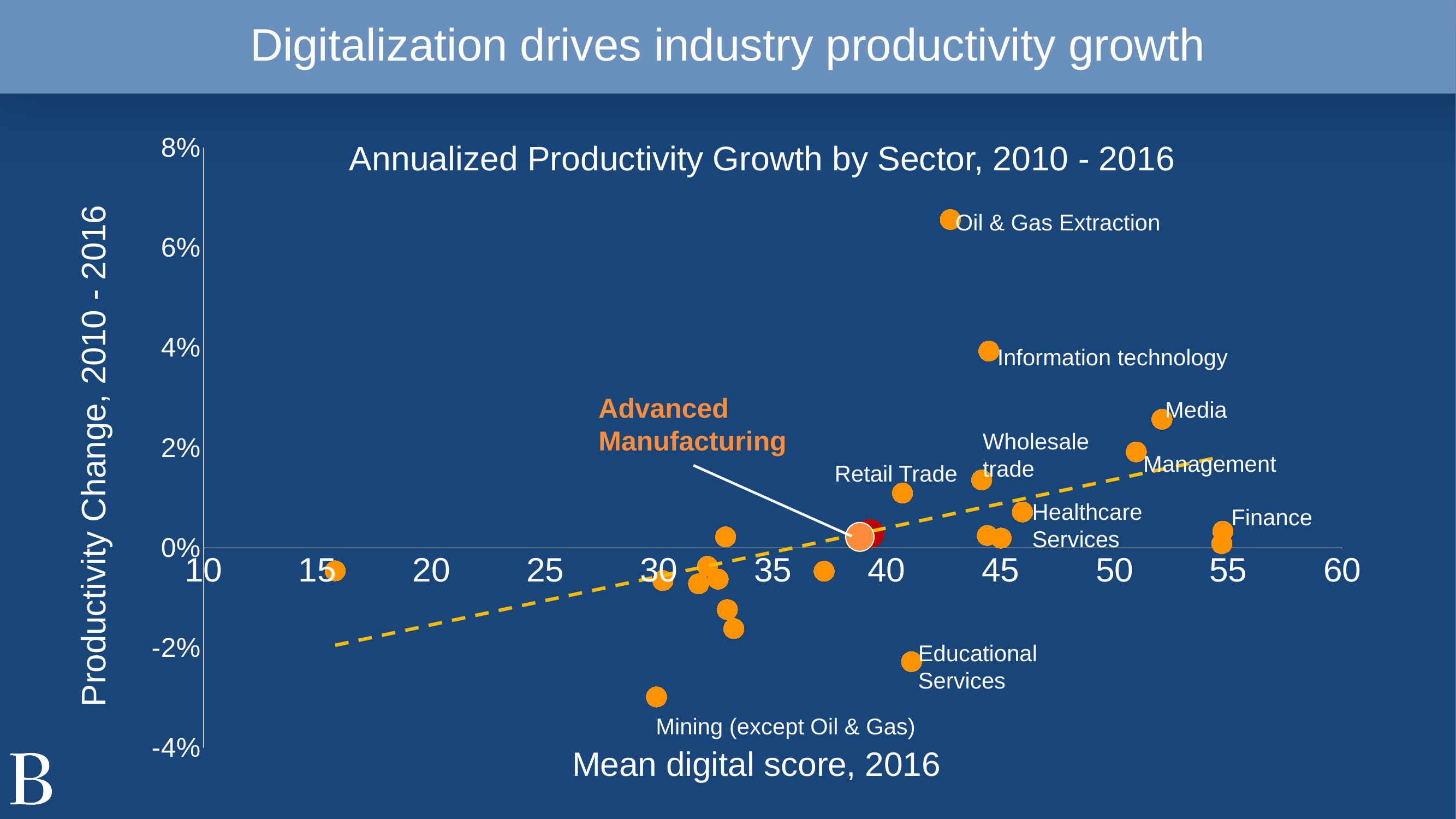
Is the productivity change for Oil & Gas Extraction greater or less than 6%? greater Is the productivity change for Mining (except Oil & Gas) greater or less than -2%? less Is the productivity change for Finance greater or less than 2%? less Does the dashed trend line rise or fall as the mean digital score increases? Rises Which has a higher productivity change, Information technology or Oil & Gas Extraction? Oil & Gas Extraction What is the label of the x axis? Mean digital score, 2016 Which labeled sector has the lowest productivity change? Mining (except Oil & Gas) What is the title of the chart? Annualized Productivity Growth by Sector, 2010 - 2016 What kind of chart is shown on the slide? Scatter chart Which labeled sector has the highest productivity change? Oil & Gas Extraction Which has a higher mean digital score, Finance or Mining (except Oil & Gas)? Finance